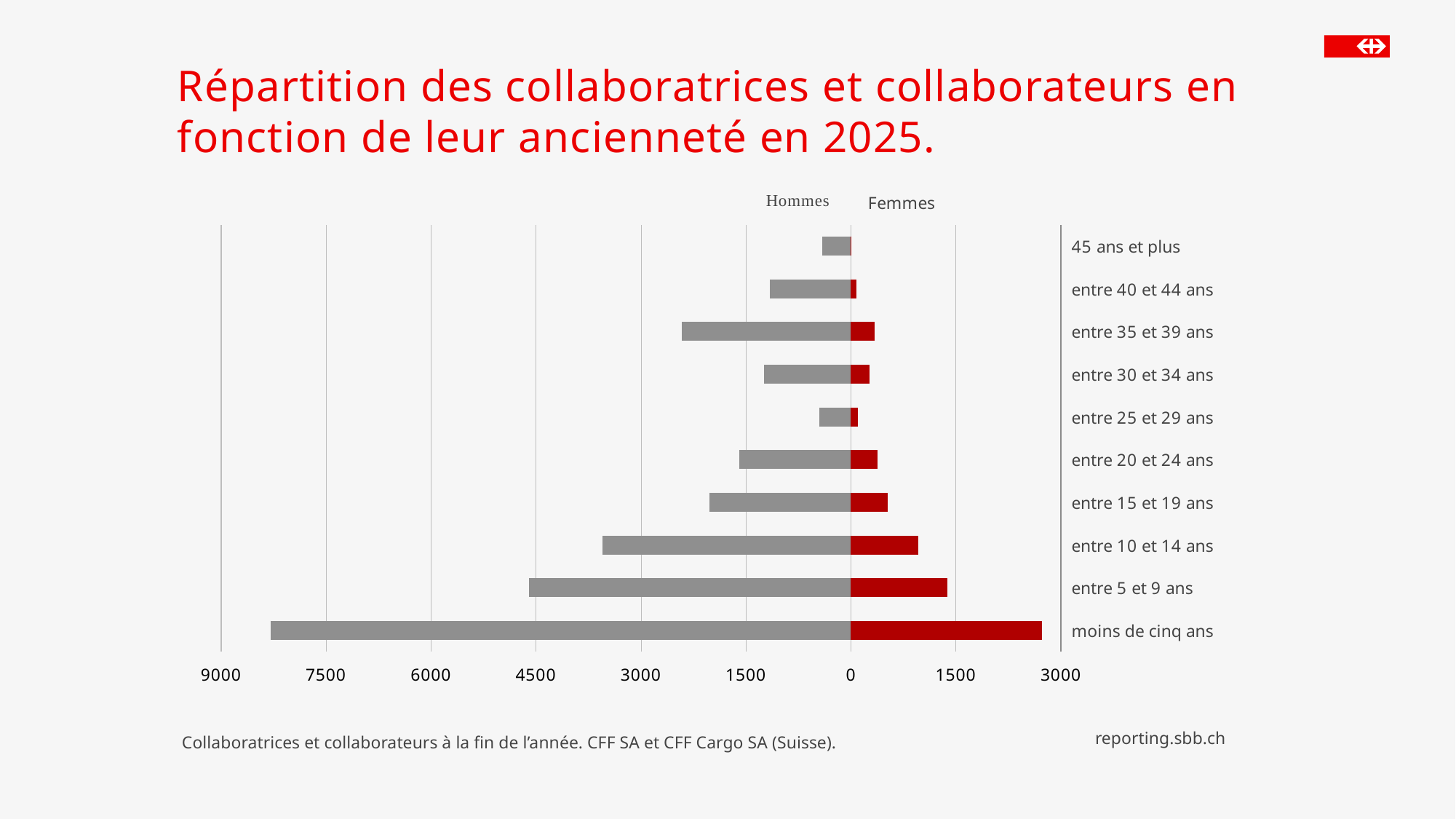
Which is larger, the Hommes value for 'entre 35 et 39 ans' or for 'entre 30 et 34 ans'? entre 35 et 39 ans Which seniority category has the highest Femmes value? moins de cinq ans Which seniority category has the highest Hommes value? moins de cinq ans Which seniority category has the lowest Femmes value? 45 ans et plus What kind of chart is shown on the slide? bar chart What colour are the Femmes bars on the chart? red Is the Hommes value for 'entre 10 et 14 ans' greater or less than 3000? greater Is the Femmes value for 'moins de cinq ans' greater or less than 1500? greater How many series does the chart show? 2 Is the Femmes value for 'entre 10 et 14 ans' greater or less than 1500? less How many seniority categories are plotted on the chart? 10